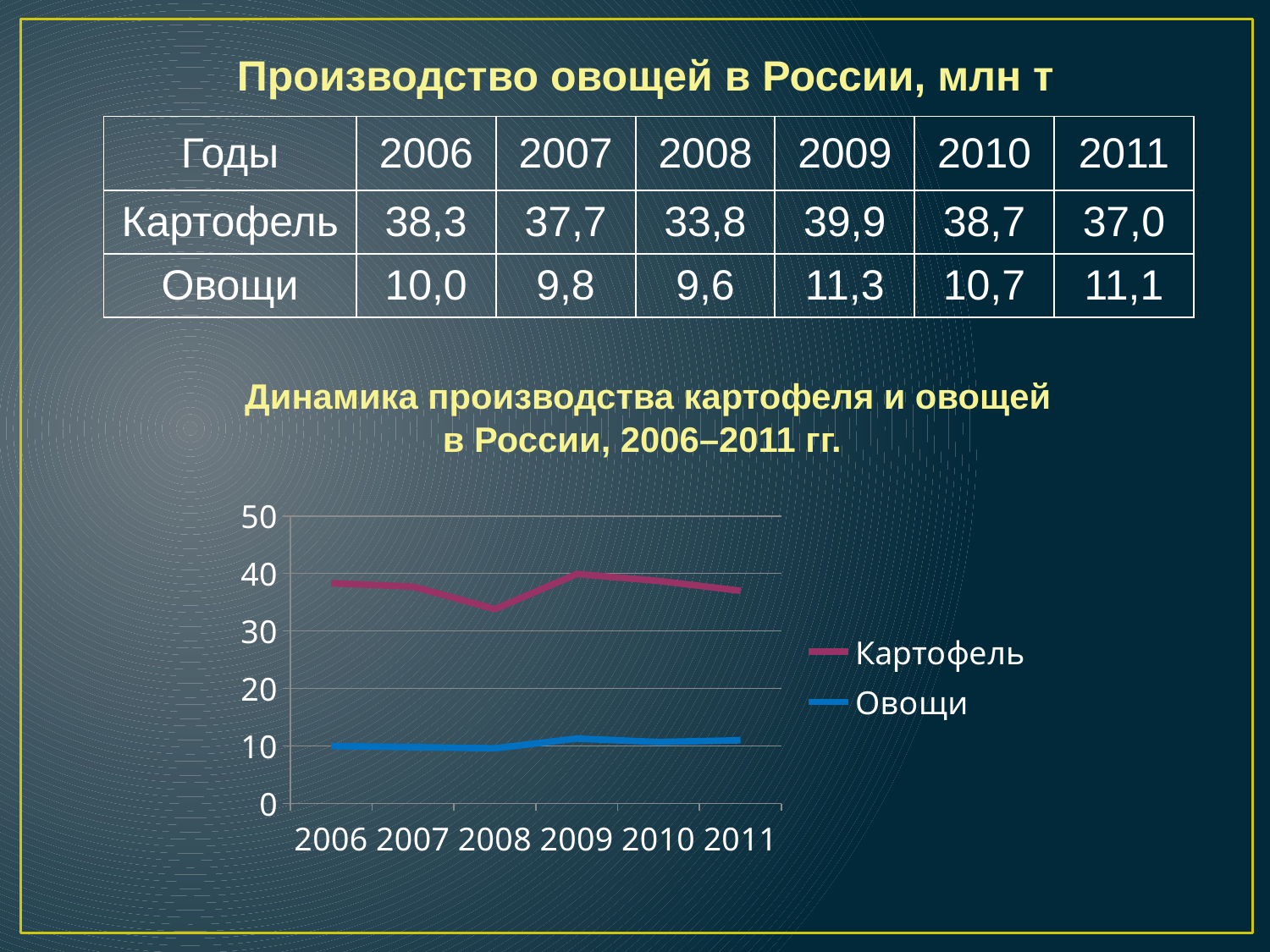
According to the slide, what is the production of Картофель in 2009, in million tonnes? 39,9 What is the difference between Картофель production in 2009 and 2008, using the values printed on the slide? 6,1 Which series is plotted higher on the chart, Картофель or Овощи? Картофель What is the title of the chart on the slide? Динамика производства картофеля и овощей в России, 2006–2011 гг. How many years are plotted along the x axis of the chart? 6 What kind of chart is shown on the slide? line chart In which year is the Картофель line at its highest point? 2009 According to the slide, what is the production of Овощи in 2008, in million tonnes? 9,6 Is the value for Овощи in 2009 greater or less than 20? less In which year is the Картофель line at its lowest point? 2008 How many series does the chart legend list? 2 Is the value for Картофель in 2008 greater or less than 40? less